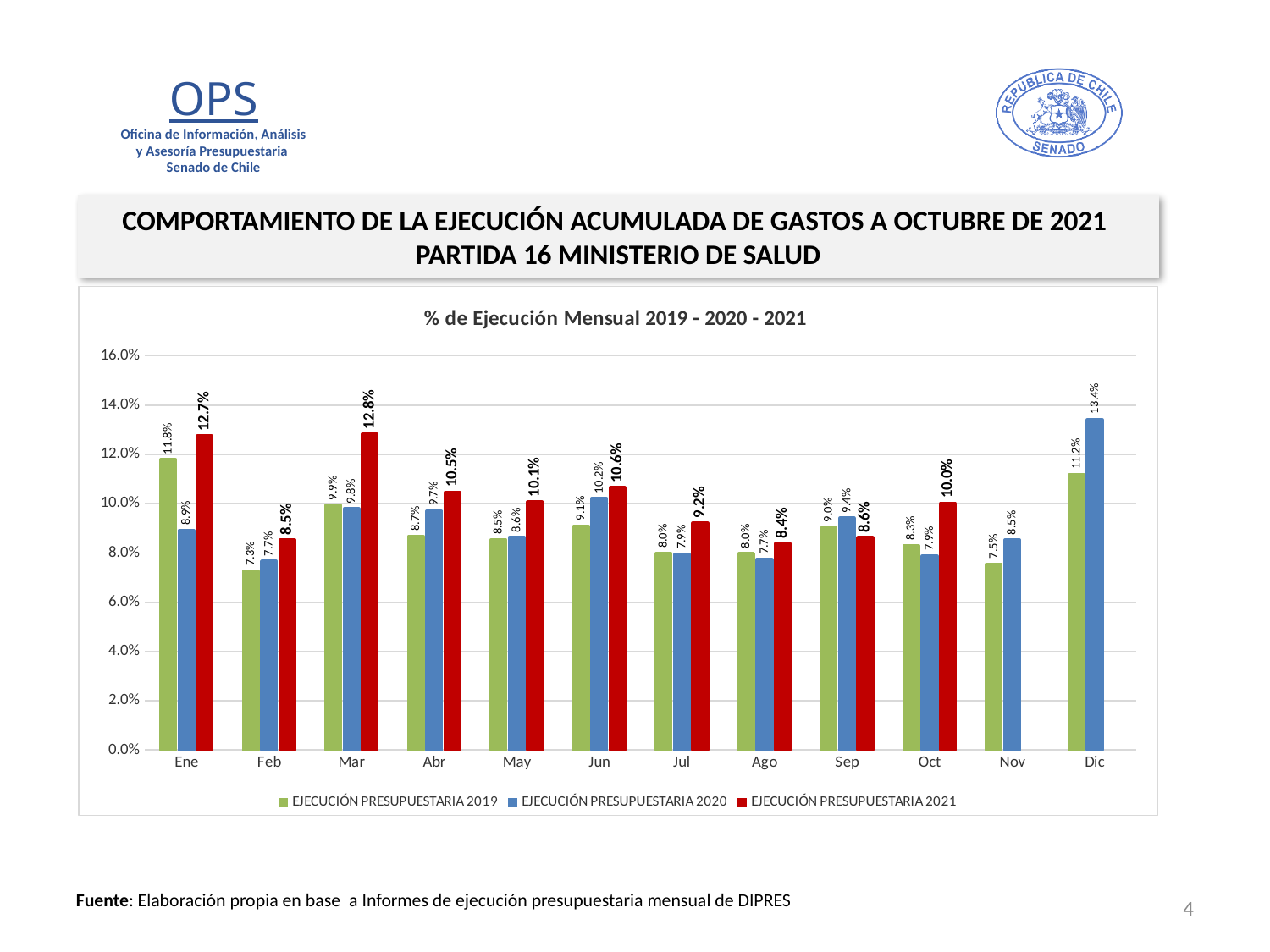
In which month is the EJECUCIÓN PRESUPUESTARIA 2021 value highest? Mar Which is larger in Sep: EJECUCIÓN PRESUPUESTARIA 2020 or EJECUCIÓN PRESUPUESTARIA 2021? EJECUCIÓN PRESUPUESTARIA 2020 What is the difference between the EJECUCIÓN PRESUPUESTARIA 2021 and EJECUCIÓN PRESUPUESTARIA 2019 values in Ene? 0.9% What is the value for EJECUCIÓN PRESUPUESTARIA 2019 in Ene? 11.8% How many series does the legend list? 3 What kind of chart is shown on the slide? Bar chart What is the value for EJECUCIÓN PRESUPUESTARIA 2020 in Dic? 13.4% What is the value for EJECUCIÓN PRESUPUESTARIA 2021 in Oct? 10.0% How many months are shown on the x axis? 12 What is the value for EJECUCIÓN PRESUPUESTARIA 2021 in Mar? 12.8% What is the title of the chart? % de Ejecución Mensual 2019 - 2020 - 2021 In which month is the EJECUCIÓN PRESUPUESTARIA 2019 value lowest? Feb